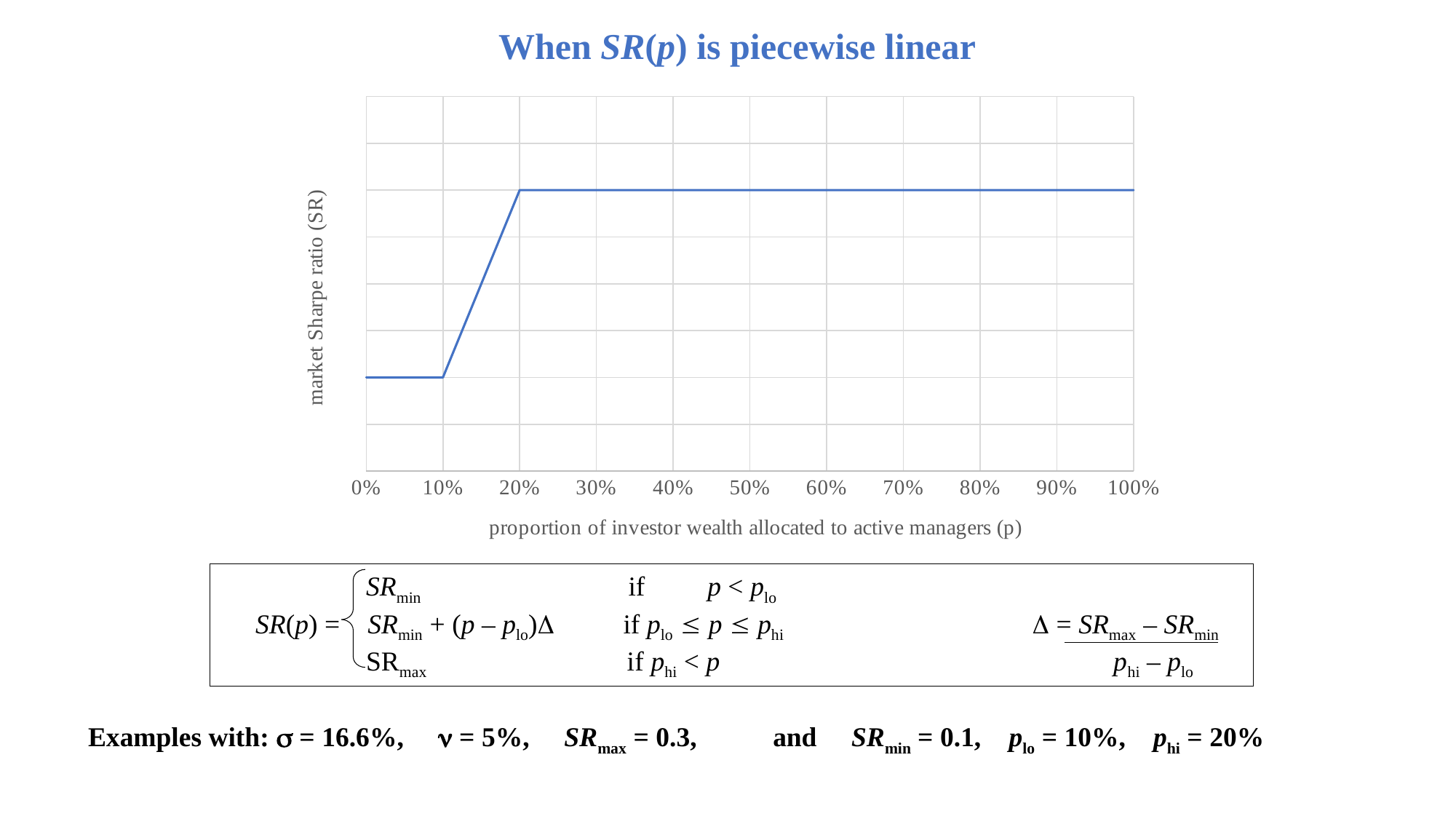
Does the line rise, fall, or stay flat between 0% and 10% on the x axis? stay flat Does the line rise, fall, or stay flat between 20% and 100% on the x axis? stay flat At which x-axis value does the line begin to rise? 10% Which has the lower market Sharpe ratio on the chart: p = 0% or p = 80%? p = 0% Over the whole x axis from 0% to 100%, does the line overall rise or fall? rise What kind of chart is shown on the slide? line chart What is the label of the x axis of the chart? proportion of investor wealth allocated to active managers (p) Which has the higher market Sharpe ratio on the chart: p = 5% or p = 50%? p = 50% At which x-axis value does the line stop rising and become flat? 20% What is the title of the slide containing the chart? When SR(p) is piecewise linear How many tick labels are shown on the x axis of the chart? 11